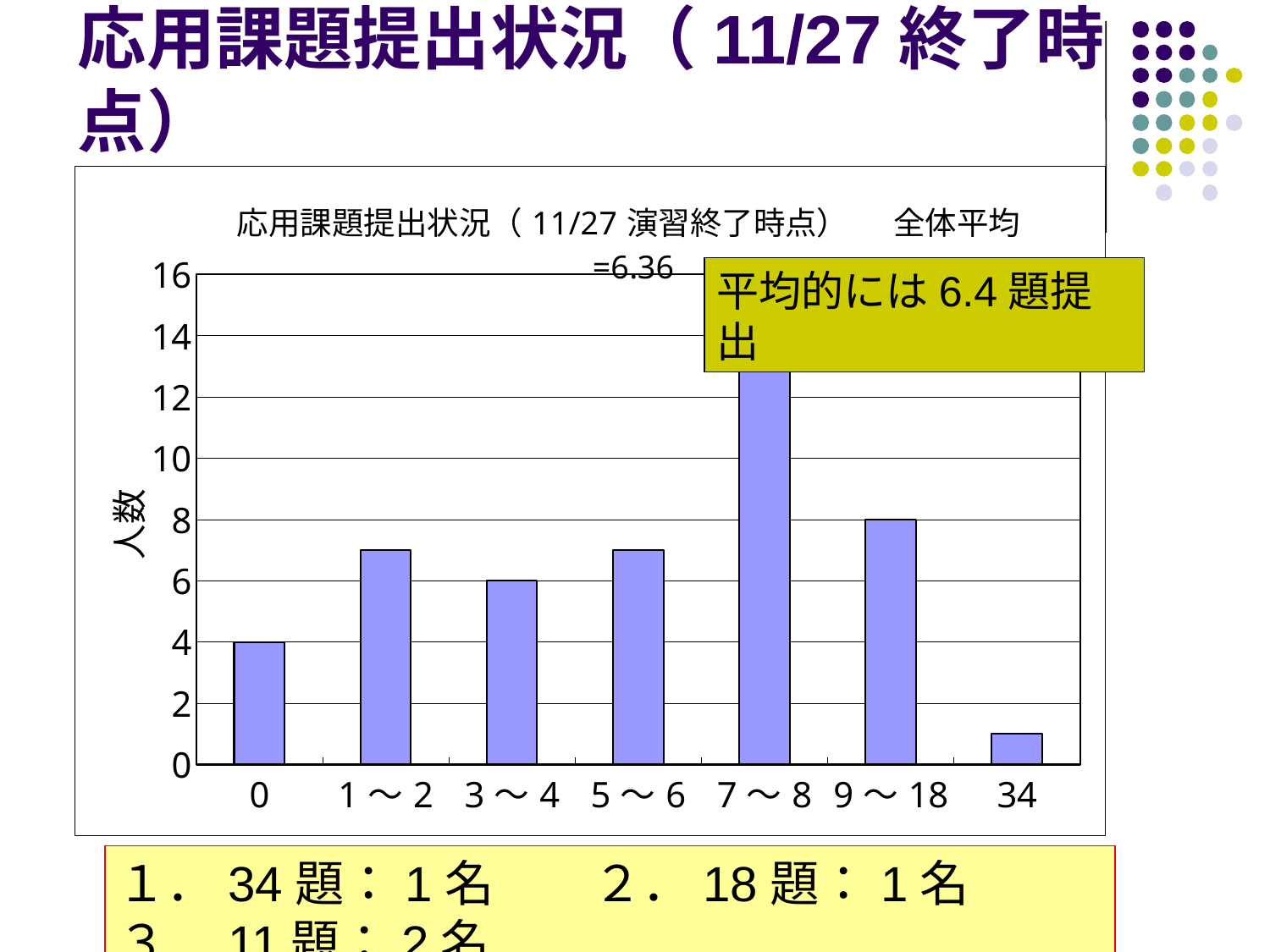
Which category has the highest bar? 7～8 How many categories are shown on the x axis of the chart? 7 What is the difference between the values for 9～18 and 0? 4 What is the label on the y axis of the chart? 人数 Which category has the lowest bar? 34 Which is larger, the value for 0 or the value for 3～4? 3～4 Is the value for 1～2 greater or less than 6? greater What is the value (人数) for the category 9～18? 8 Is the value for 34 greater or less than 2? less What is the value (人数) for the category 3～4? 6 What kind of chart is shown on the slide? bar chart What is the value (人数) for the category 0? 4